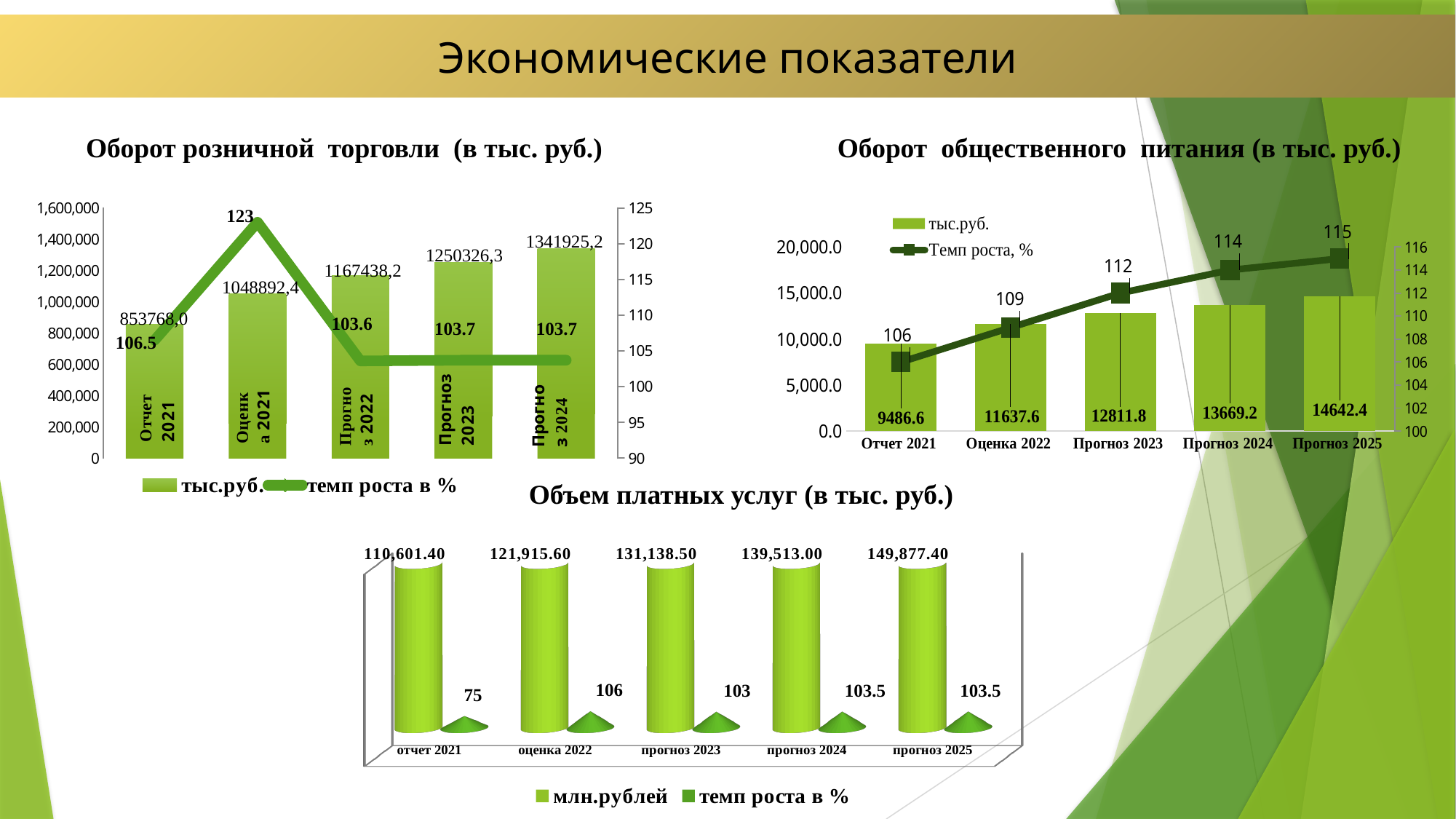
In the chart 'Оборот общественного питания (в тыс. руб.)', which category has the lowest тыс.руб. value? Отчет 2021 In the chart 'Оборот розничной торговли (в тыс. руб.)', how many categories are shown on the x axis? 5 In the chart 'Оборот розничной торговли (в тыс. руб.)', what is the темп роста в % value for Оценка 2021? 123 In the chart 'Оборот общественного питания (в тыс. руб.)', how many series does the legend list? 2 In the chart 'Оборот розничной торговли (в тыс. руб.)', what is the value of тыс.руб. for Прогноз 2024? 1341925,2 In the chart 'Оборот общественного питания (в тыс. руб.)', what is the Темп роста, % value for Прогноз 2025? 115 In the chart 'Оборот розничной торговли (в тыс. руб.)', which category has the highest темп роста в %? Оценка 2021 In the chart 'Оборот общественного питания (в тыс. руб.)', what is the тыс.руб. value for Прогноз 2023? 12811.8 In the chart 'Объем платных услуг (в тыс. руб.)', which is larger, the темп роста в % for оценка 2022 or for прогноз 2023? оценка 2022 In the chart 'Объем платных услуг (в тыс. руб.)', what is the темп роста в % value for отчет 2021? 75 In the chart 'Объем платных услуг (в тыс. руб.)', what is the млн.рублей value for прогноз 2025? 149,877.40 In the chart 'Оборот общественного питания (в тыс. руб.)', do the тыс.руб. values rise or fall from Отчет 2021 to Прогноз 2025? rise